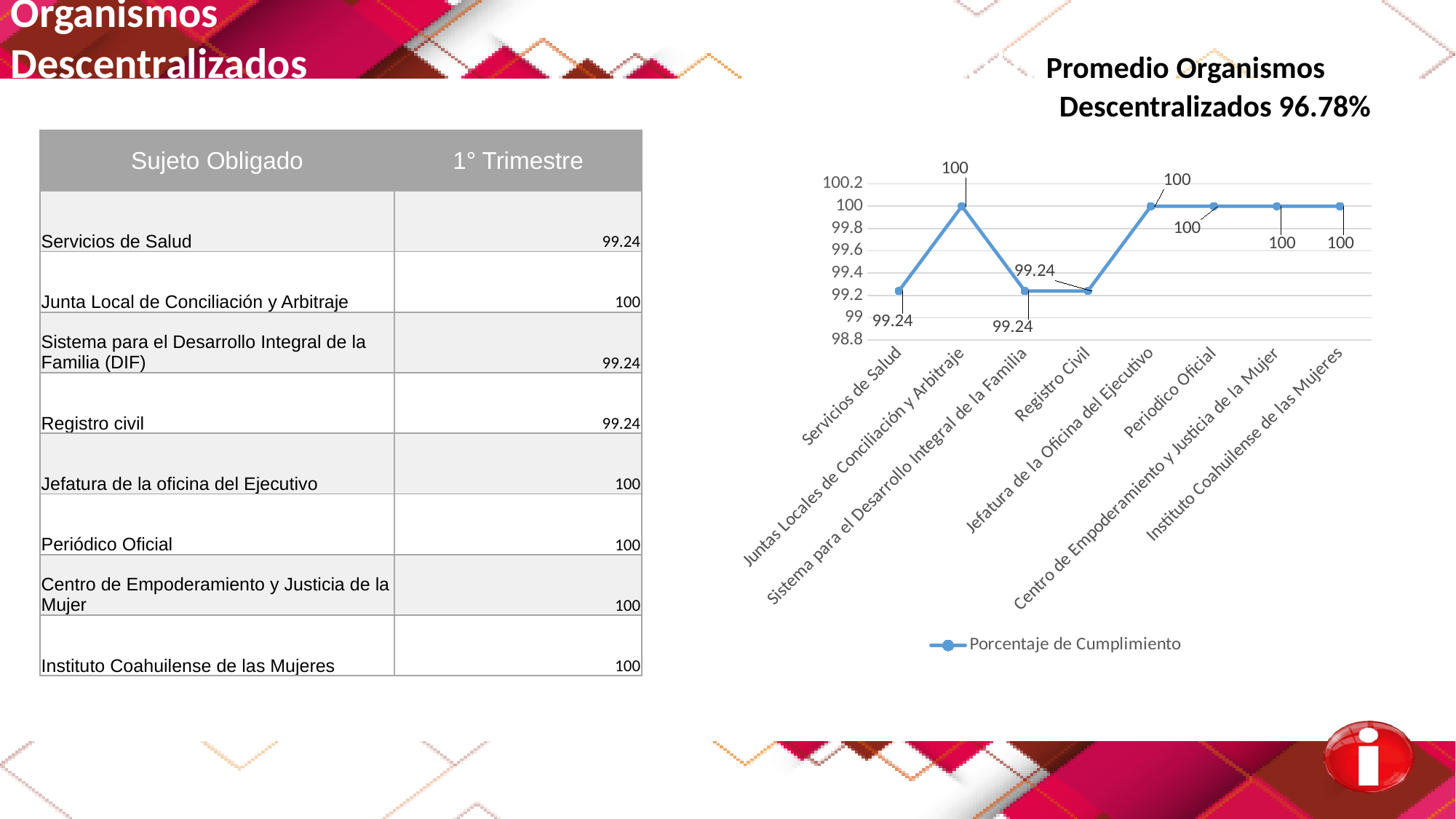
How many series does the legend list? 1 What is the value for Registro Civil? 99.24 What is the value for Periodico Oficial? 100 What kind of chart is shown on the slide? line chart Is the value for Registro Civil greater or less than 99.6? less What is the name of the series shown in the legend? Porcentaje de Cumplimiento What is the difference between the value for Juntas Locales de Conciliación y Arbitraje and the value for Sistema para el Desarrollo Integral de la Familia? 0.76 What is the value for Servicios de Salud? 99.24 What is the value for Juntas Locales de Conciliación y Arbitraje? 100 How many categories are plotted on the x axis? 8 Do the values rise or fall from Registro Civil to Jefatura de la Oficina del Ejecutivo? rise Which category has the lowest value: Servicios de Salud or Jefatura de la Oficina del Ejecutivo? Servicios de Salud